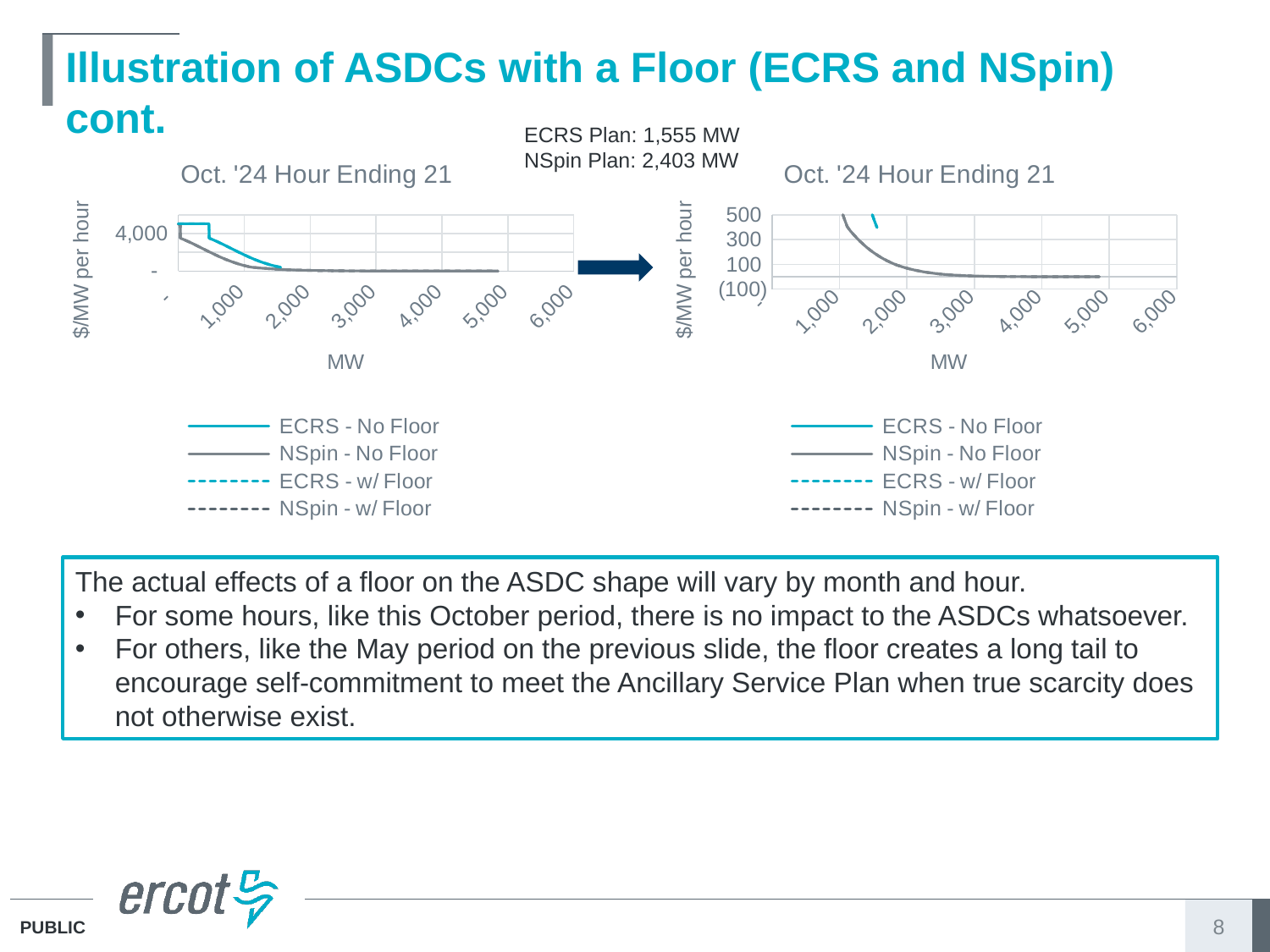
What kind of chart is the left chart on the slide? line chart In the left chart, do the values rise or fall as MW increases along the x axis? fall In the right chart, do the values rise or fall as MW increases along the x axis? fall What is the label of the y axis on the left chart? $/MW per hour What kind of chart is the right chart on the slide? line chart How many series does the legend of the right chart list? 4 In the left chart, is the value of ECRS - No Floor at 3,000 MW greater or less than 4,000? less What is the label of the x axis on the right chart? MW How many series does the legend of the left chart list? 4 In the left chart, which series is drawn as a dashed line: ECRS - No Floor or ECRS - w/ Floor? ECRS - w/ Floor In the right chart, is the value of NSpin - No Floor at 4,000 MW greater or less than 300? less